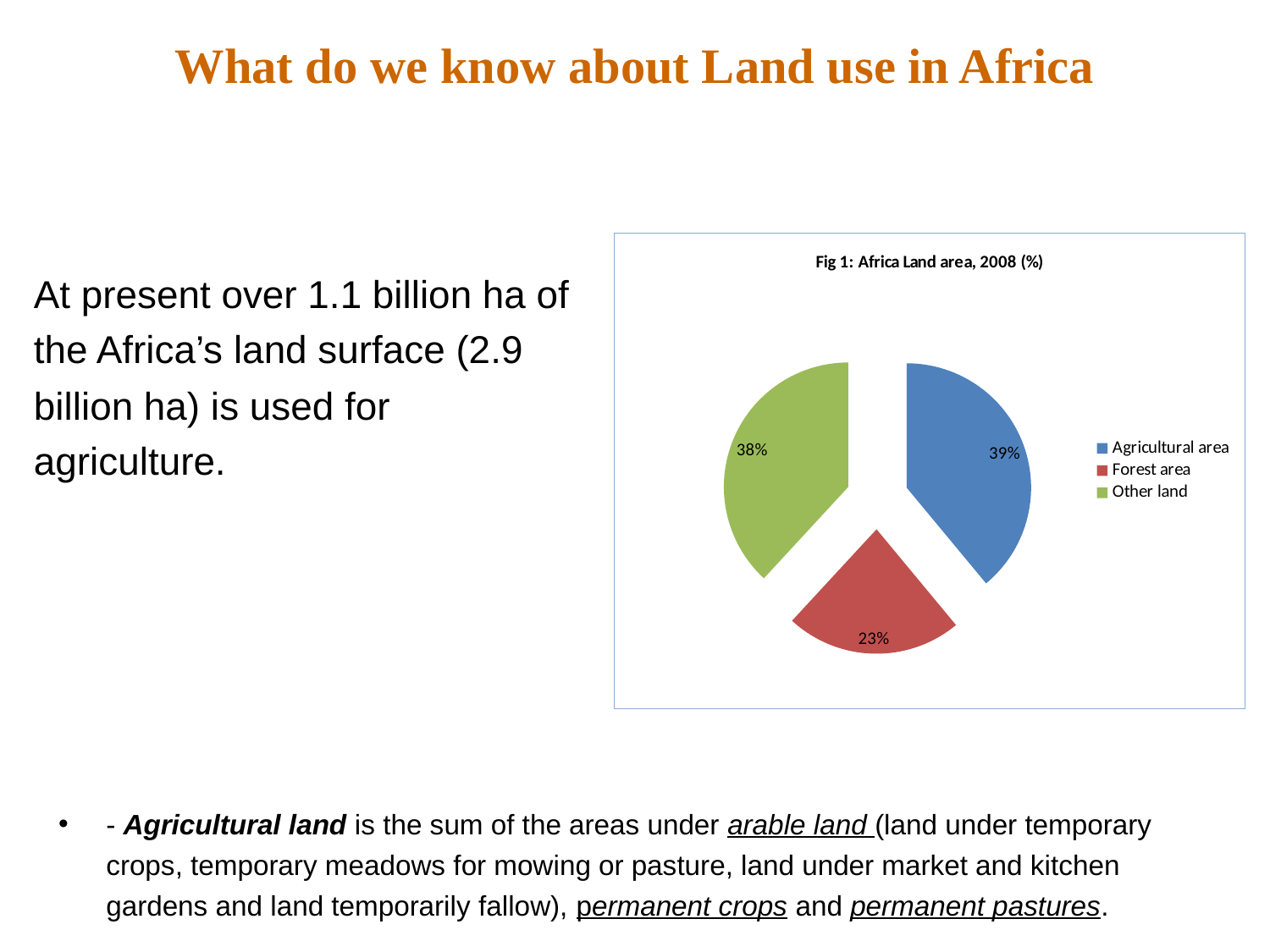
What is the difference in percentage points between Other land and Forest area? 15 What percentage of Africa's land area is Forest area? 23% Is the share for Forest area greater or less than 25%? less Which category has the smallest share of the pie? Forest area What percentage of Africa's land area is Other land? 38% What is the difference in percentage points between Agricultural area and Forest area? 16 What percentage of Africa's land area is Agricultural area? 39% What colour represents Forest area in the chart? Red Which is larger, the share for Agricultural area or the share for Forest area? Agricultural area How many categories are shown in the pie chart? 3 What is the title of the chart? Fig 1: Africa Land area, 2008 (%) What kind of chart is shown on the slide? Pie chart